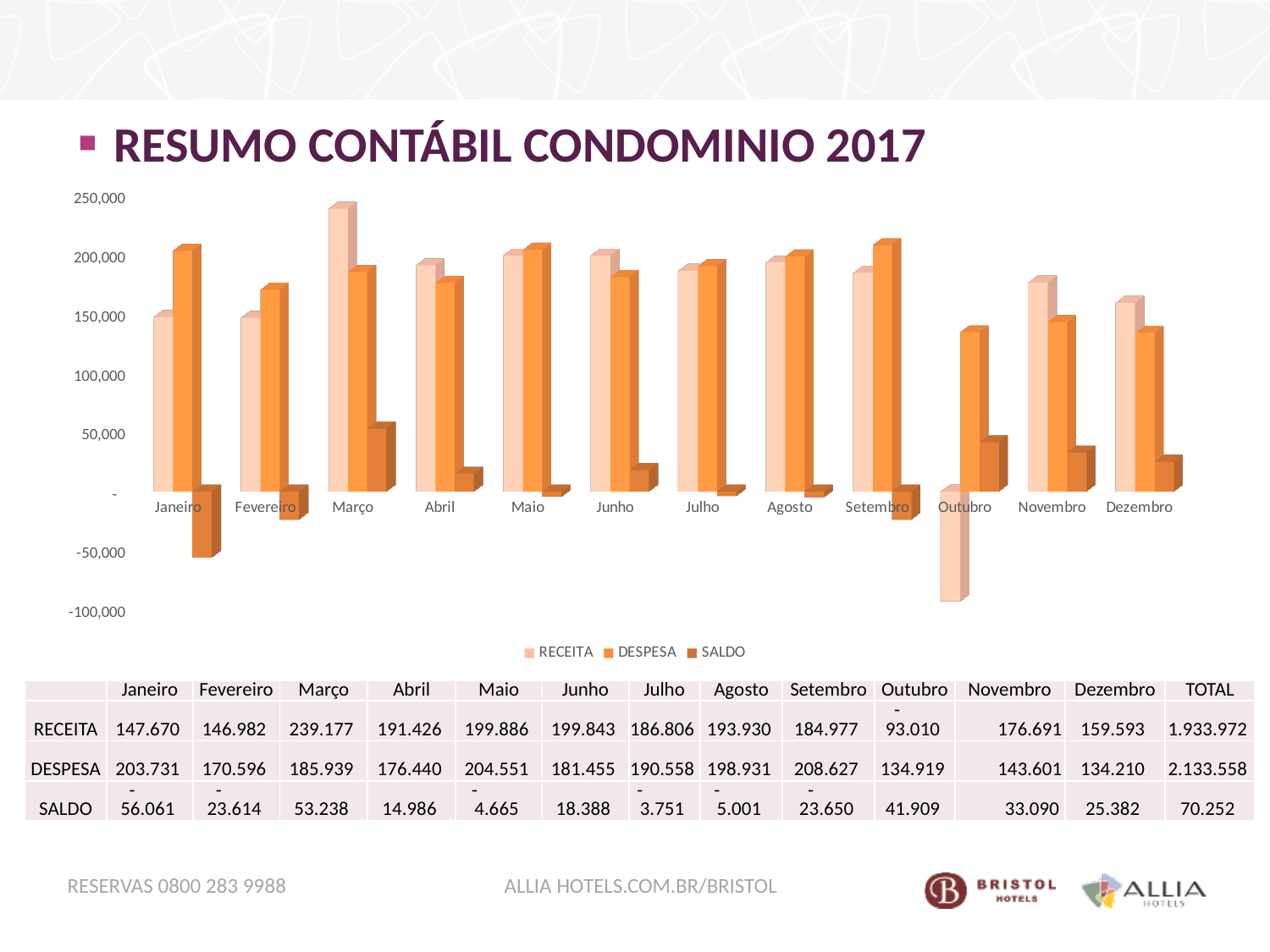
Which month has the highest RECEITA? Março What are the three series named in the legend? RECEITA, DESPESA, SALDO What is the difference between RECEITA and DESPESA in Março? 53.238 What kind of chart is shown on the slide? bar chart How many months are shown along the x axis of the chart? 12 What is the SALDO value for Outubro? 41.909 In Janeiro, which is larger, RECEITA or DESPESA? DESPESA How many series does the legend list? 3 Which month has the lowest RECEITA? Outubro What is the RECEITA value for Março? 239.177 What is the DESPESA value for Setembro? 208.627 Is the DESPESA value for Novembro greater or less than 150,000? less